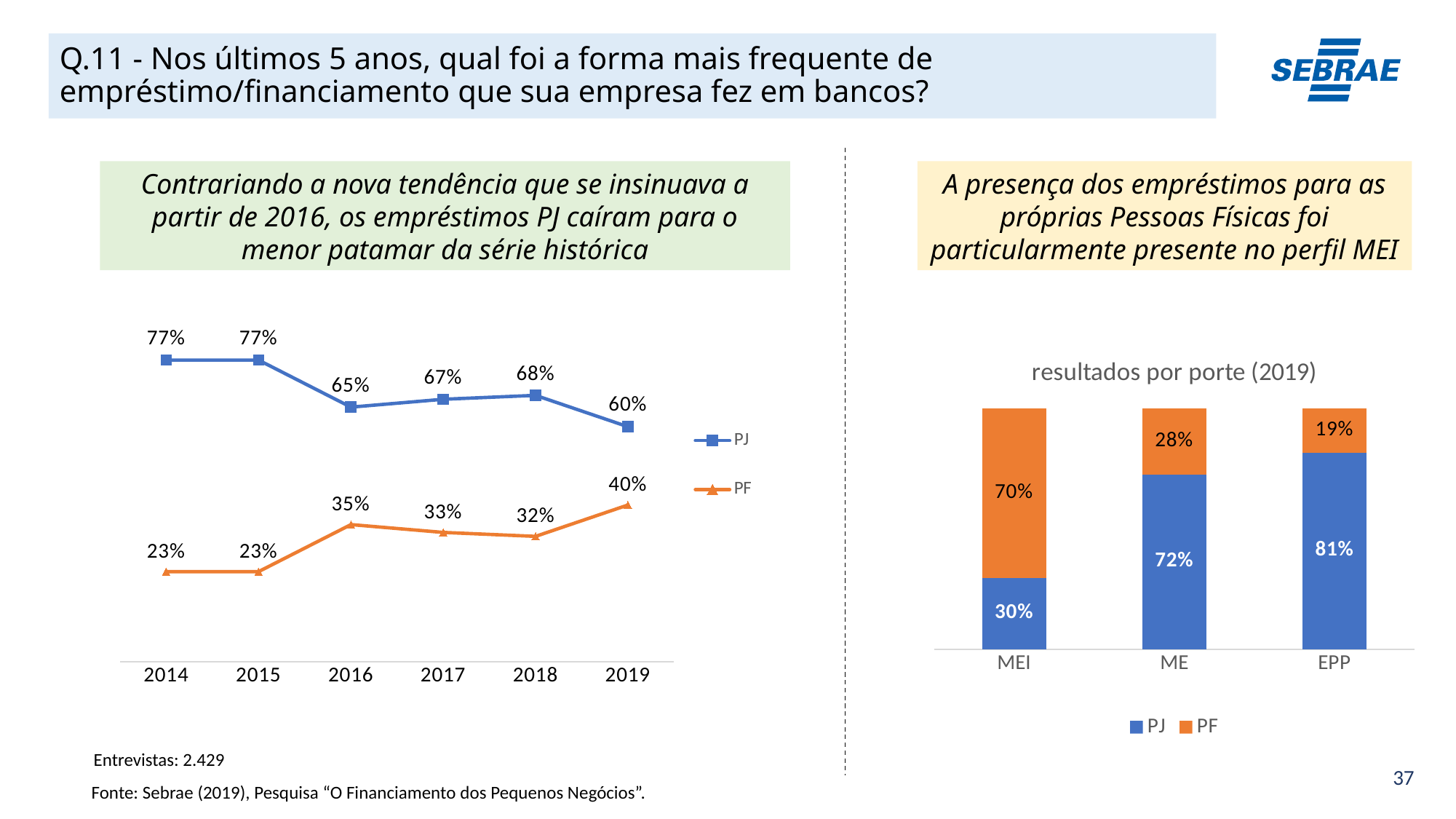
In the line chart on the left, what is the PF value for 2019? 40% In the line chart on the left, how many years are shown on the x axis? 6 In the line chart on the left, what is the difference between the PJ and PF values in 2018? 36% In the chart titled 'resultados por porte (2019)', is the PJ value for ME larger or the PJ value for MEI? ME In the chart titled 'resultados por porte (2019)', what is the total of the ME bar? 100% In the line chart on the left, does the PF series rise or fall from 2014 to 2019 overall? rise In the chart titled 'resultados por porte (2019)', what is the PF value for MEI? 70% In the line chart on the left, what is the PJ value for 2016? 65% In the line chart on the left, how many series does the legend list? 2 In the line chart on the left, which year has the lowest PJ value? 2019 In the chart titled 'resultados por porte (2019)', which category has the highest PJ value? EPP What kind of chart is the chart titled 'resultados por porte (2019)'? stacked bar chart